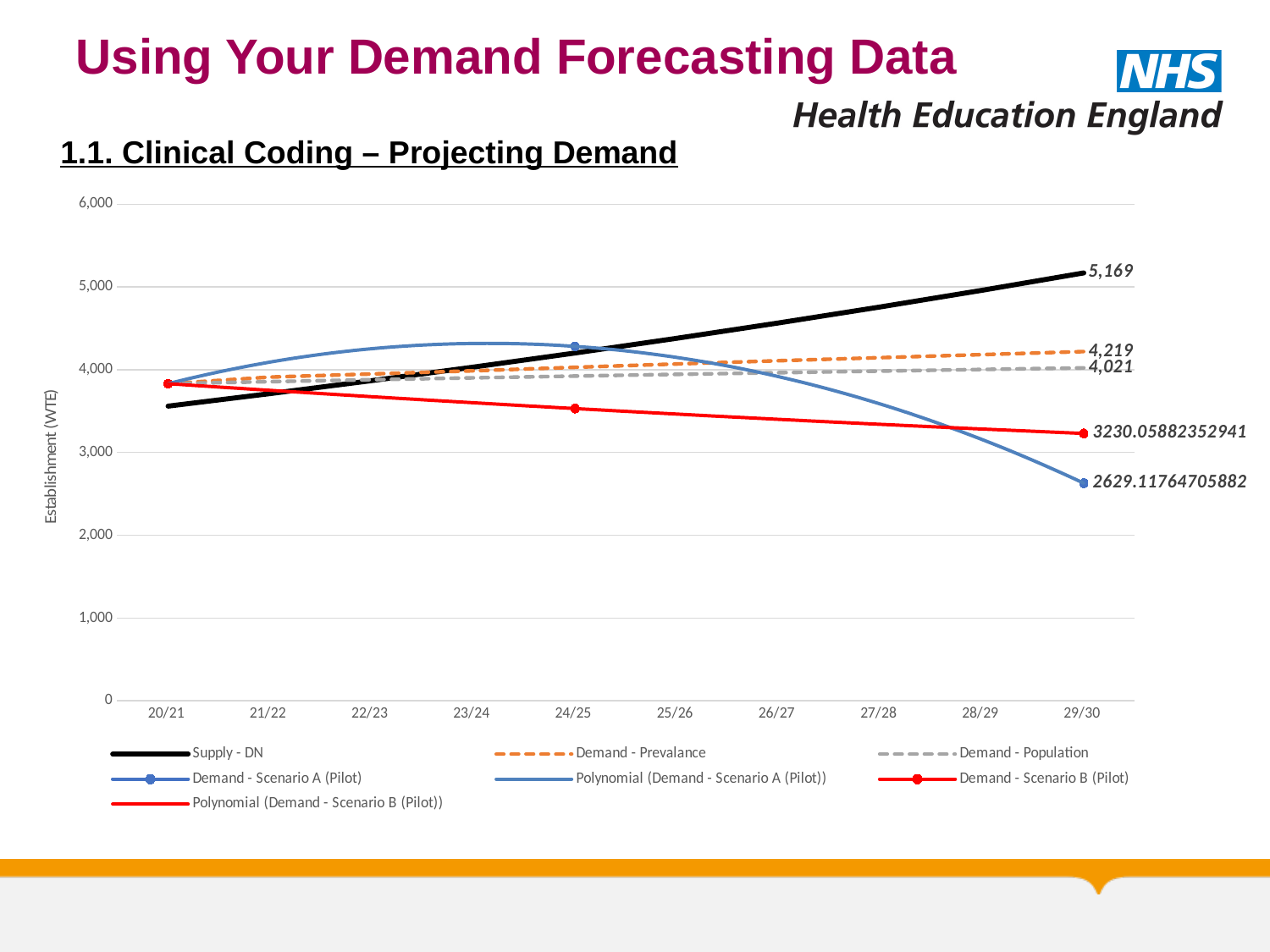
What type of chart is shown on the slide? line chart What is the difference between Demand - Prevalance and Demand - Population in 29/30? 198 What is the value of Supply - DN in 29/30? 5,169 What is the value of Demand - Prevalance in 29/30? 4,219 What is the value of Demand - Population in 29/30? 4,021 What is the value of Demand - Scenario A (Pilot) in 29/30? 2629.11764705882 How many series does the legend list? 7 What is the value of Demand - Scenario B (Pilot) in 29/30? 3230.05882352941 Which series has the highest value in 29/30? Supply - DN How many periods are shown on the x axis? 10 Which series has the lowest value in 29/30? Demand - Scenario A (Pilot) Is the value for Supply - DN in 20/21 greater or less than 4,000? less